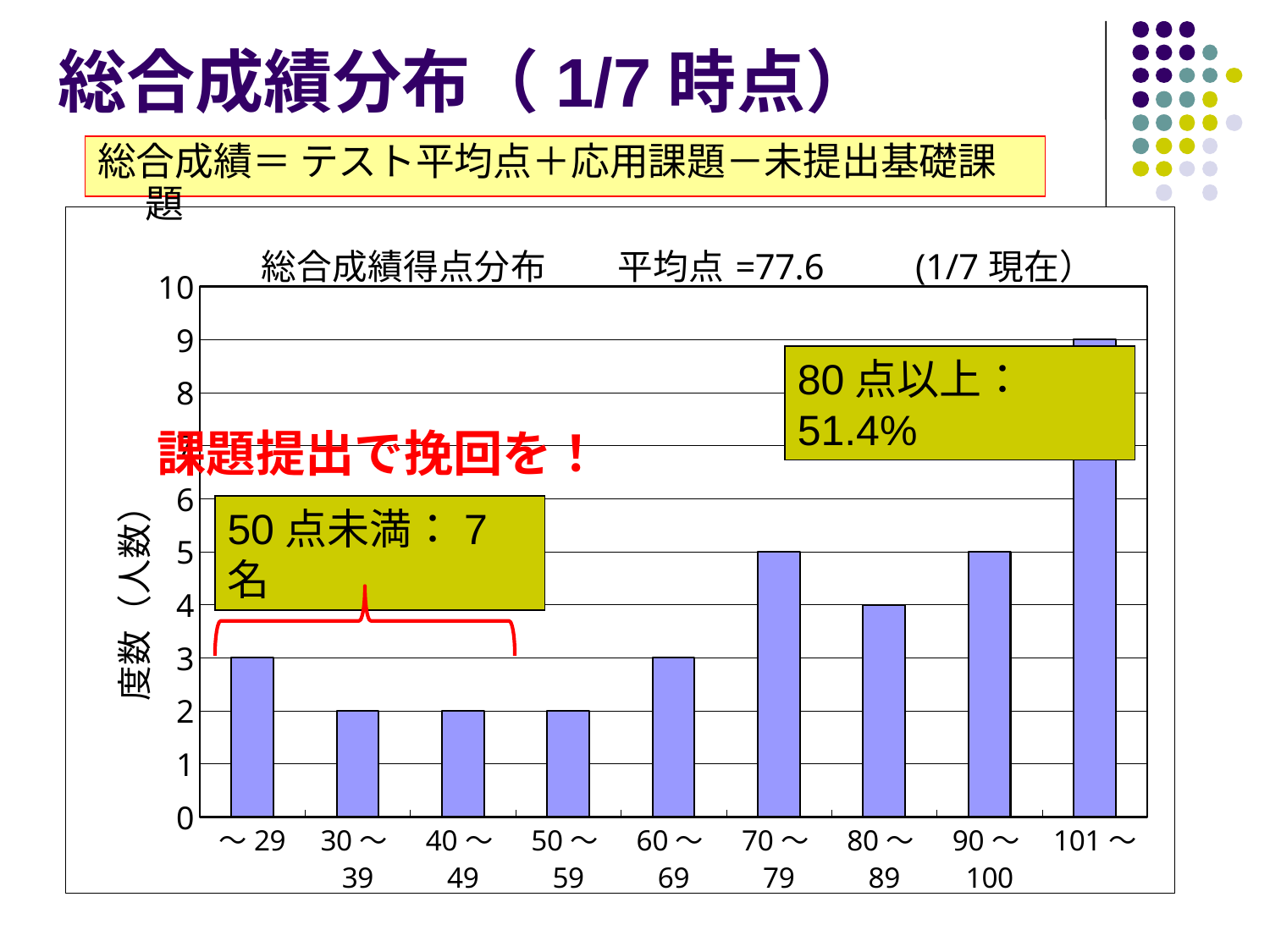
Which is larger, the value for 60～69 or the value for 80～89? 80～89 How many score-range categories are shown on the x axis? 9 What is the value for the 80～89 category? 4 What is the total of the values for ～29, 30～39 and 40～49? 7 What is the value (度数) for the 101～ category? 9 What is the value for the ～29 category? 3 What kind of chart is shown on the slide? bar chart What is the y-axis label of the chart? 度数（人数） What is the difference between the values for 101～ and 70～79? 4 What average score (平均点) is stated in the chart title? 77.6 Is the value for 101～ greater or less than 8? greater Which category has the highest value? 101～